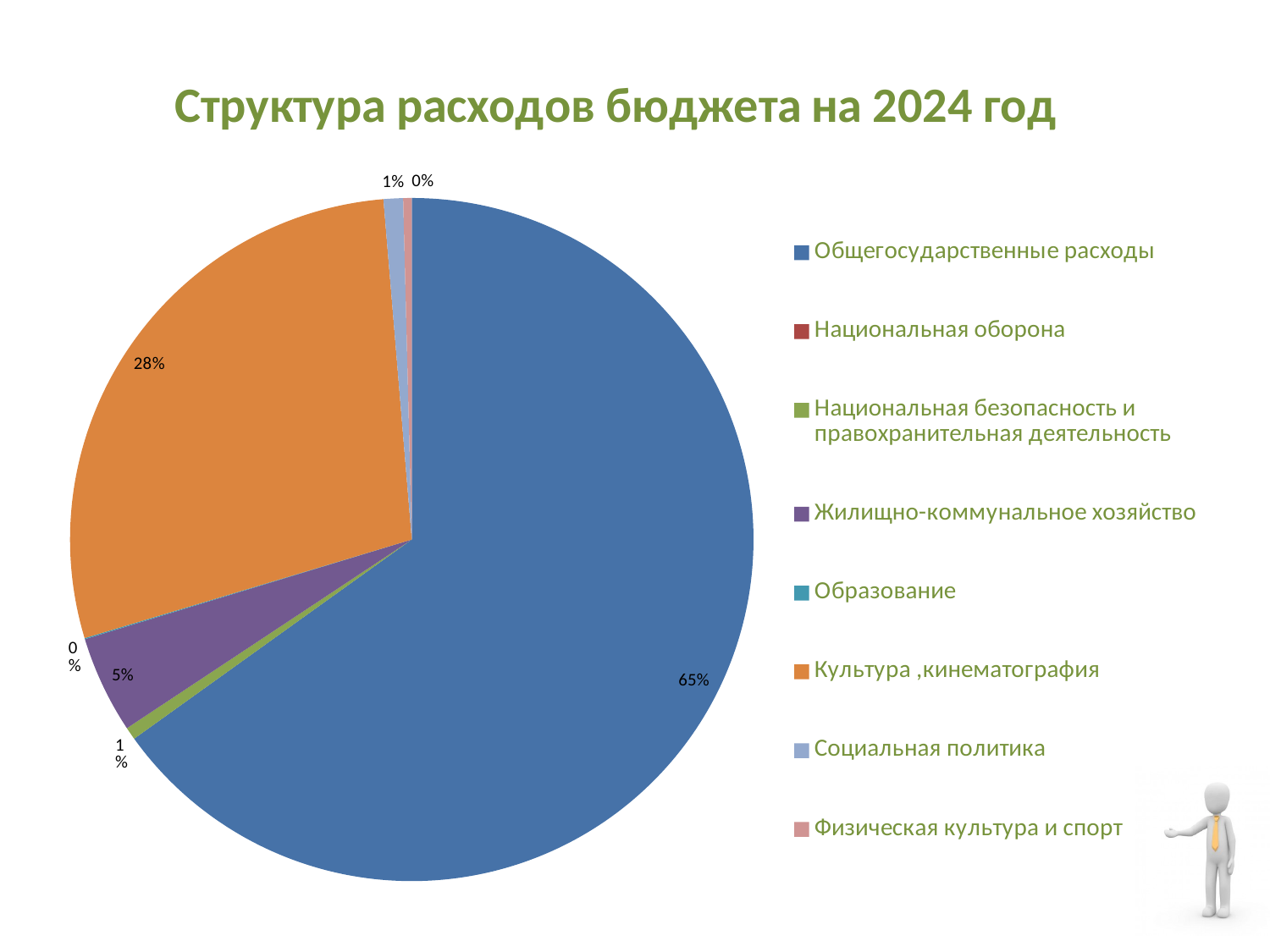
What share of the pie is Общегосударственные расходы? 65% What is the title of the chart? Структура расходов бюджета на 2024 год What colour is the slice for Культура ,кинематография? orange What is the difference between the shares of Общегосударственные расходы and Культура ,кинематография? 37% How many entries does the legend list? 8 What is the combined share of Общегосударственные расходы and Культура ,кинематография? 93% What share of the pie is Культура ,кинематография? 28% Which is larger: Культура ,кинематография or Жилищно-коммунальное хозяйство? Культура ,кинематография What share of the pie is Жилищно-коммунальное хозяйство? 5% Which category has the largest slice of the pie? Общегосударственные расходы What kind of chart is shown on the slide? pie chart